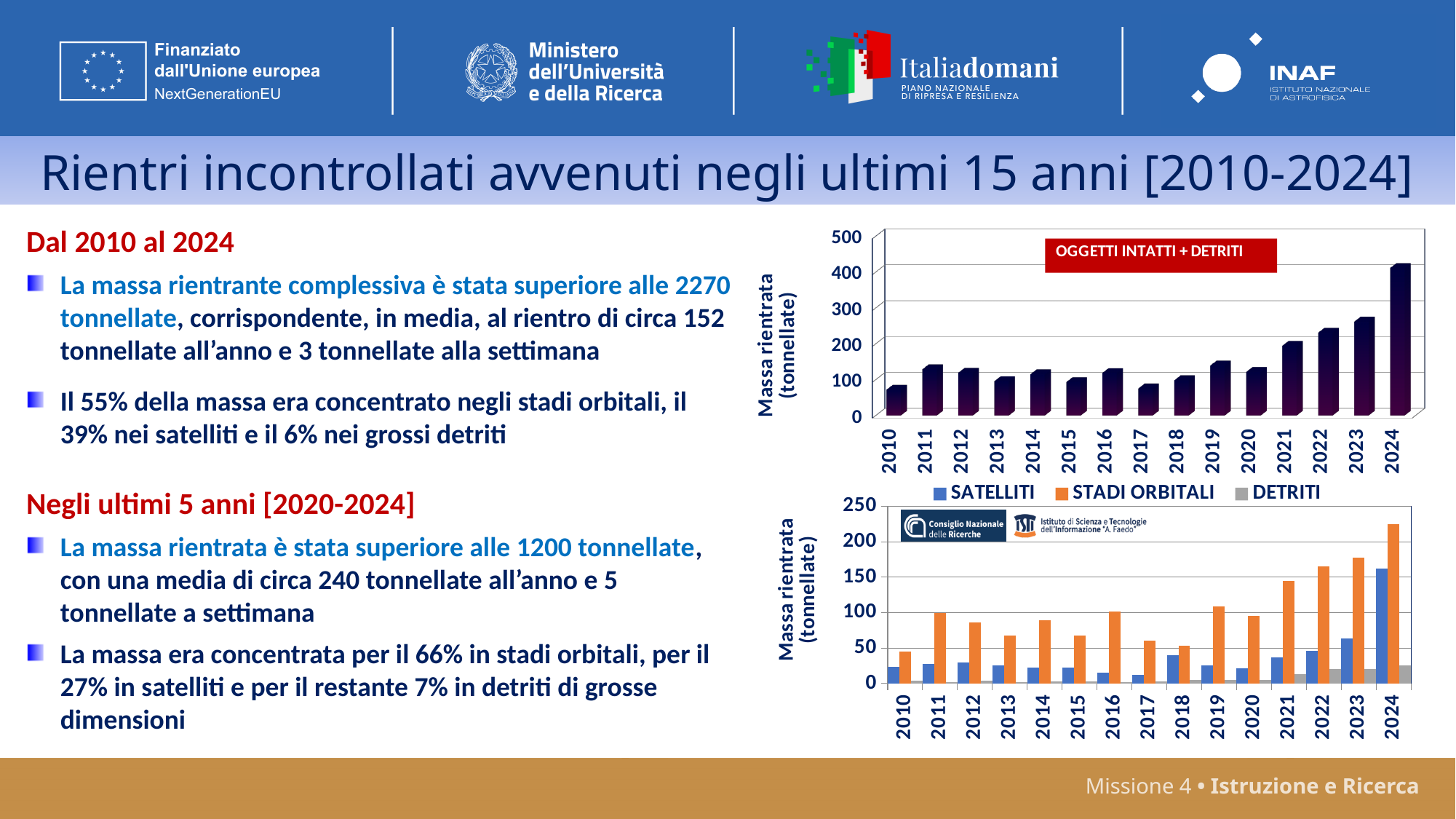
In the top chart 'OGGETTI INTATTI + DETRITI', how many years are shown on the x axis? 15 In the top chart 'OGGETTI INTATTI + DETRITI', which year has the highest value? 2024 In the bottom chart, is the value for STADI ORBITALI in 2024 greater or less than 200? greater How many series does the legend of the bottom chart list? 3 In the top chart 'OGGETTI INTATTI + DETRITI', do the values generally rise or fall from 2020 to 2024? rise In the bottom chart, which year has the highest value for STADI ORBITALI? 2024 In the top chart 'OGGETTI INTATTI + DETRITI', is the value for 2024 greater or less than 300? greater What is the label on the y axis of the bottom chart? Massa rientrata (tonnellate) In the top chart 'OGGETTI INTATTI + DETRITI', is the value for 2010 greater or less than 100? less In the bottom chart, which is larger in 2024: SATELLITI or STADI ORBITALI? STADI ORBITALI What kind of chart is the top chart titled 'OGGETTI INTATTI + DETRITI'? bar chart